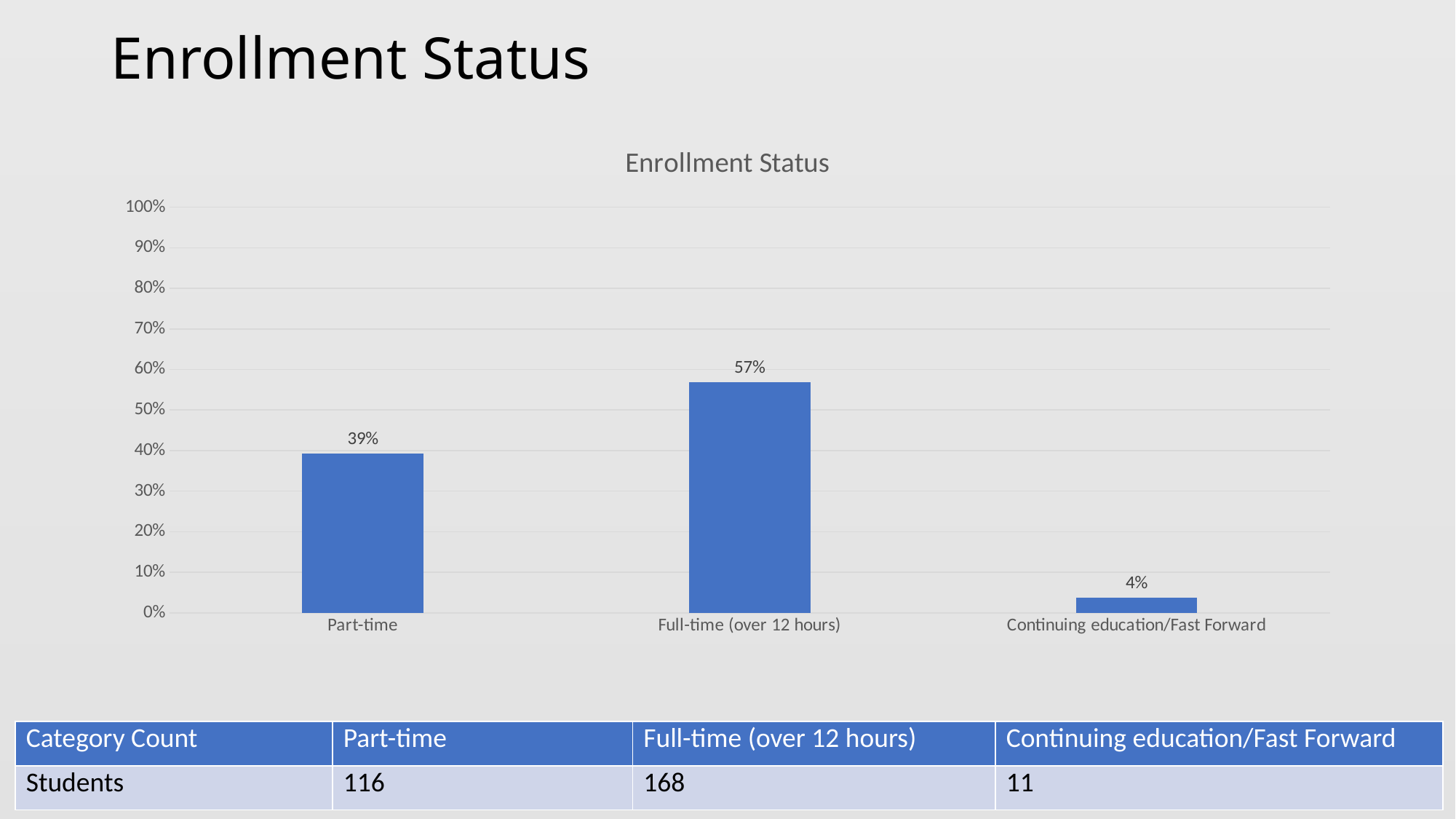
What kind of chart is shown on the slide? bar chart What is the value for Full-time (over 12 hours)? 57% What is the title of the chart? Enrollment Status What is the value for Continuing education/Fast Forward? 4% Is the value for Full-time (over 12 hours) greater or less than 50%? greater Which category has the lowest value? Continuing education/Fast Forward What is the value for Part-time? 39% What is the difference between the values for Full-time (over 12 hours) and Part-time? 18% Which is larger, the value for Part-time or the value for Continuing education/Fast Forward? Part-time Which category has the highest value? Full-time (over 12 hours) How many categories are shown on the chart? 3 What is the highest value shown on the vertical axis? 100%